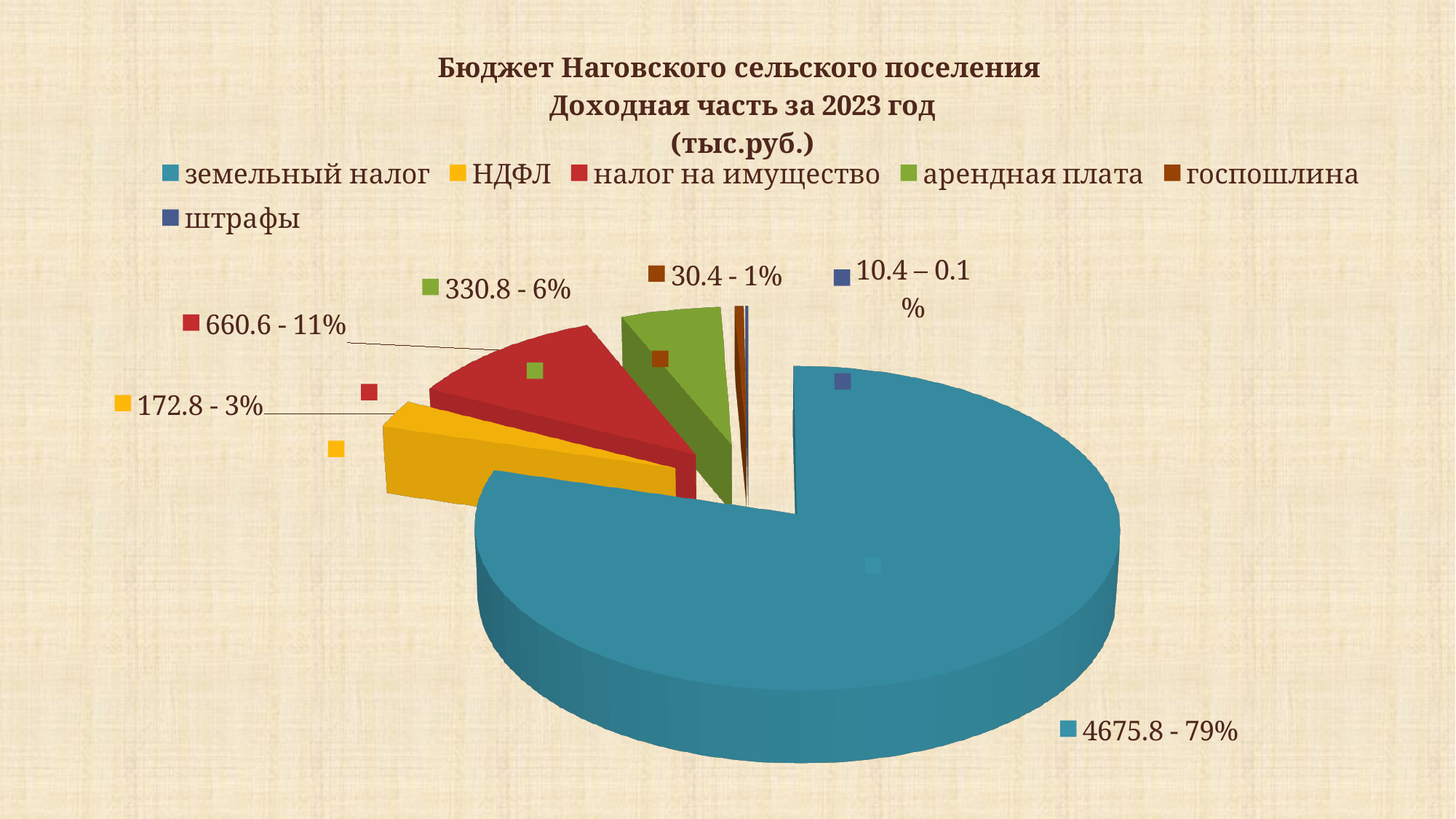
Which category has the smallest slice? штрафы What is the difference between налог на имущество and НДФЛ? 487.8 What share of the pie does штрафы take? 0.1% Which is larger, налог на имущество or арендная плата? налог на имущество What is the value for налог на имущество? 660.6 Which category has the largest slice? земельный налог What share of the pie does арендная плата take? 6% What is the value for земельный налог? 4675.8 What is the value for НДФЛ? 172.8 What kind of chart is shown on the slide? pie chart What is the value for госпошлина? 30.4 How many categories does the legend list? 6